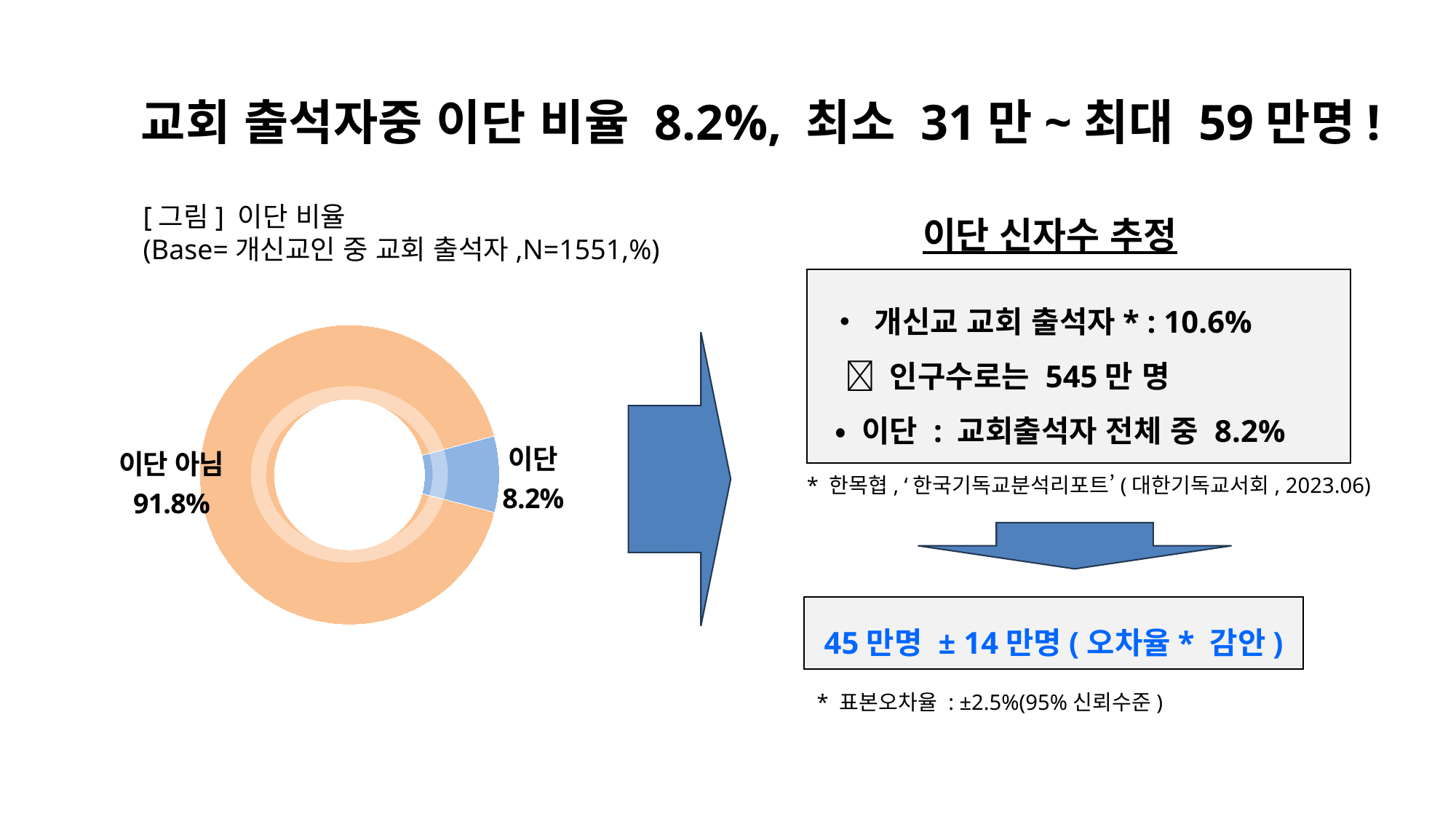
What is the difference between the shares of 이단 아님 and 이단? 83.6% Which category has the smallest share in the chart? 이단 What is the value for 이단 in the chart? 8.2% What kind of chart is shown on the slide? Doughnut (pie) chart Which category has the largest share in the chart? 이단 아님 What is the base (N) stated for the chart? N=1551 Which is larger, the share of 이단 or the share of 이단 아님? 이단 아님 How many categories are shown in the chart? 2 What colour is the 이단 slice in the chart? Blue What is the value for 이단 아님 in the chart? 91.8% What is the total of the two slices in the chart? 100%